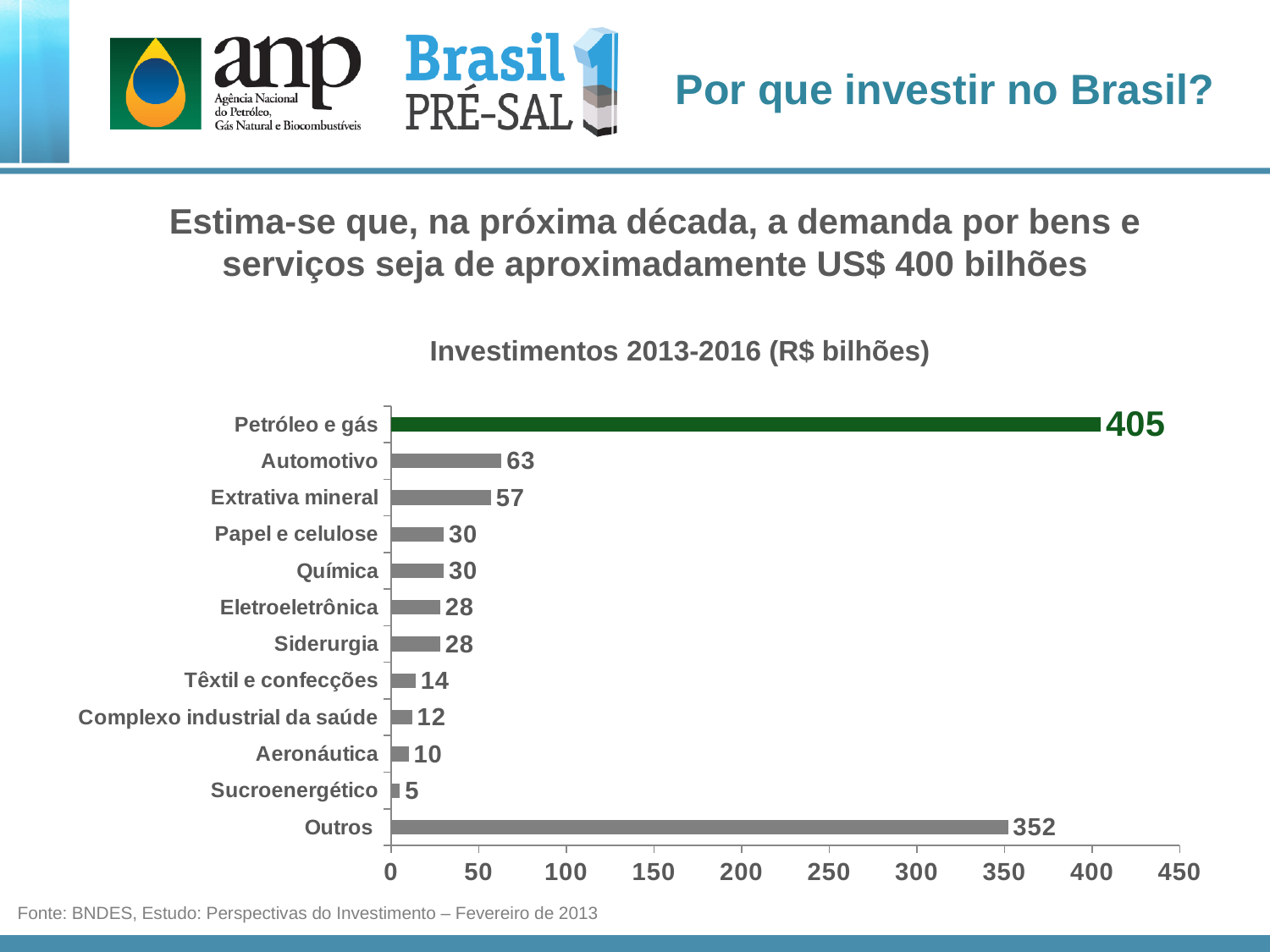
What is the difference between Têxtil e confecções and Aeronáutica? 4 What is the value for Sucroenergético? 5 What is the value for Outros? 352 Which is larger, Automotivo or Extrativa mineral? Automotivo What is the value for Petróleo e gás in the Investimentos 2013-2016 chart? 405 What is the value for Automotivo? 63 How many categories are shown in the chart? 12 Which category has the lowest value? Sucroenergético Which category has the highest value? Petróleo e gás What is the difference between Petróleo e gás and Outros? 53 What is the title of the chart? Investimentos 2013-2016 (R$ bilhões) What kind of chart is shown on the slide? Bar chart